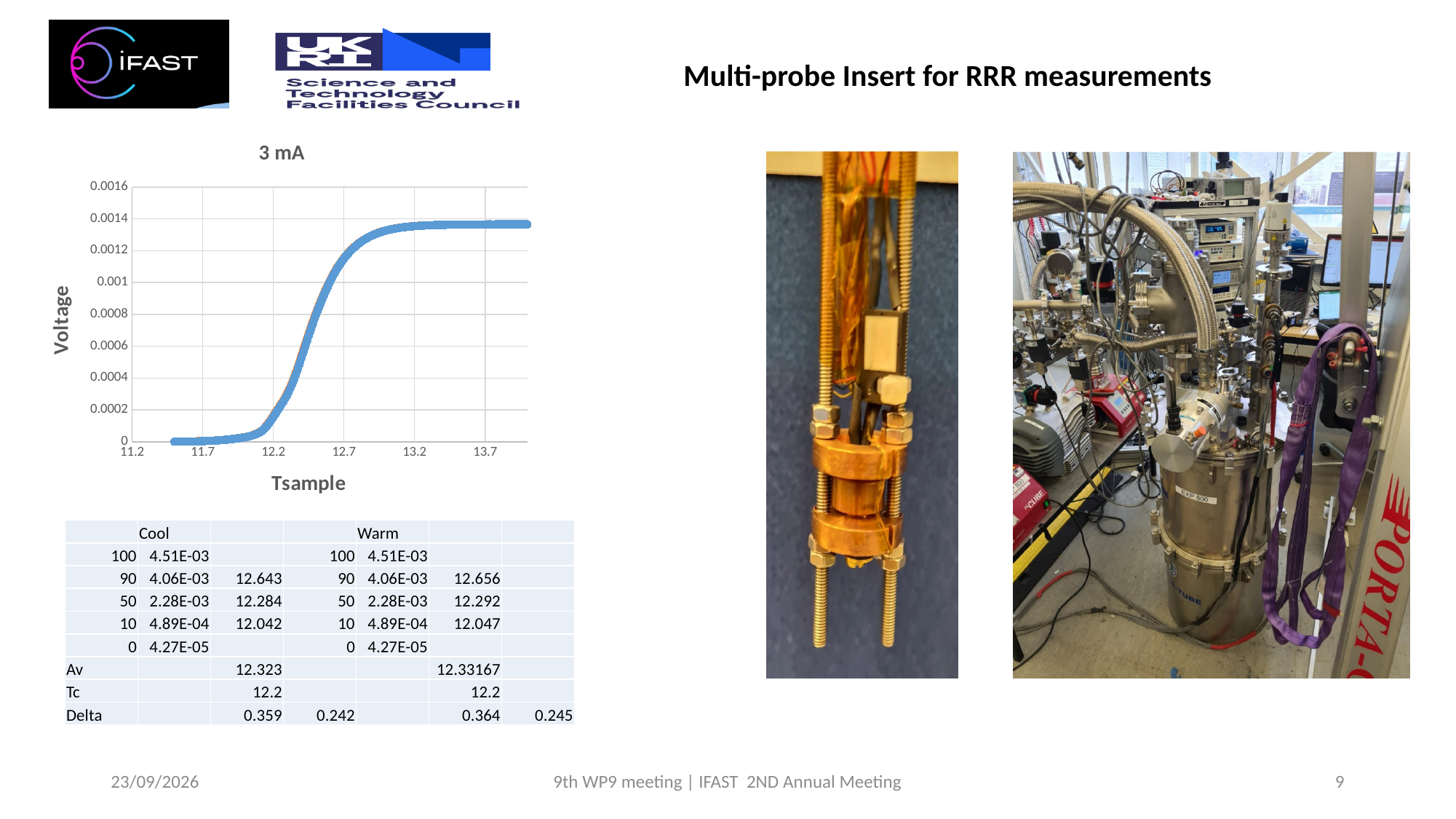
Does the voltage rise or fall as Tsample increases along the x axis? rise What is the label of the y axis of the chart? Voltage Is the voltage at Tsample 11.7 greater or less than 0.0002? less What is the highest value shown on the y axis of the chart? 0.0016 Is the voltage at Tsample 13.2 greater or less than 0.0012? greater Is the voltage at Tsample 12.7 greater or less than 0.001? greater What is the title of the chart on the slide? 3 mA Which is larger, the voltage at Tsample 12.2 or the voltage at Tsample 12.7? Tsample 12.7